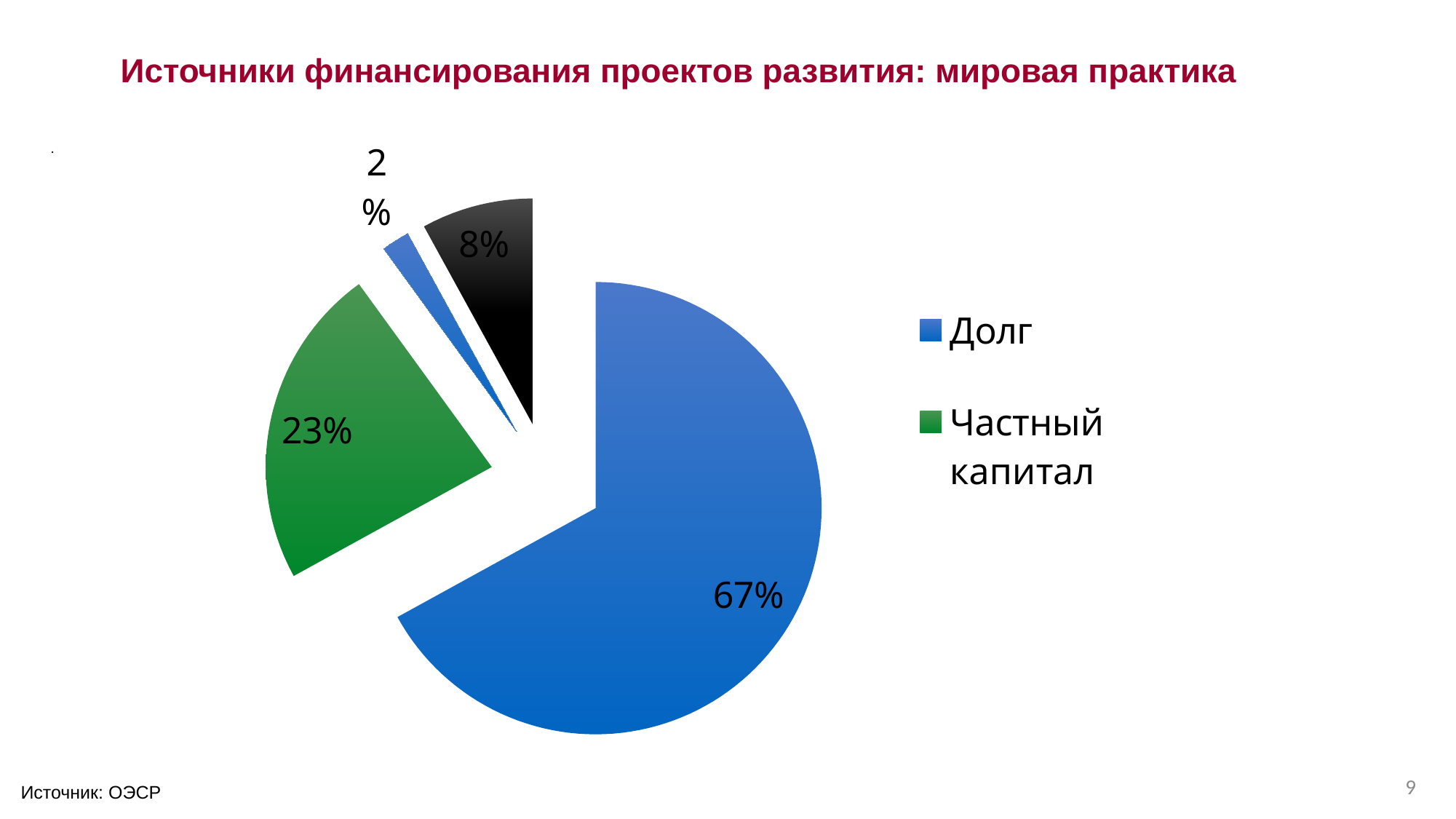
How many entries does the legend list? 2 What is the smallest percentage shown on the pie chart? 2% What is the difference in percentage points between the Долг slice and the Частный капитал slice? 44 percentage points Which category has the largest slice of the pie? Долг Which is larger, the slice for Долг or the slice for Частный капитал? Долг What share of the pie does Долг account for? 67% What is the value shown for Частный капитал? 23% What kind of chart is shown on the slide? Pie chart What is the title of the slide? Источники финансирования проектов развития: мировая практика How many slices does the pie chart have? 4 What source is cited at the bottom of the slide? ОЭСР What percentage is labelled on the black slice? 8%